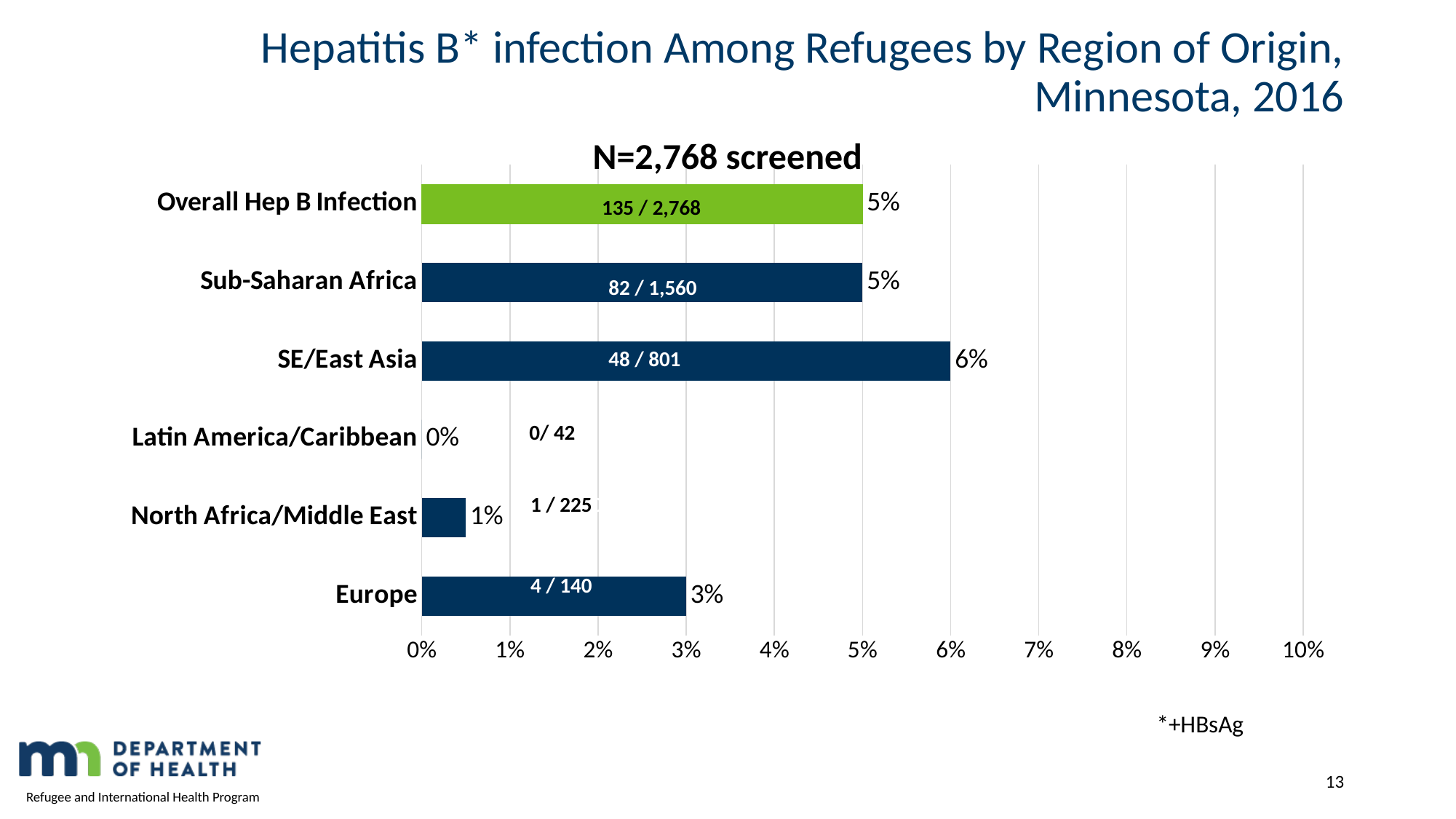
Which has a higher infection percentage, Europe or North Africa/Middle East? Europe What fraction is shown for Latin America/Caribbean? 0/ 42 What is the Hepatitis B infection percentage for SE/East Asia? 6% What is the Hepatitis B infection percentage for Europe? 3% Which region has the lowest Hepatitis B infection percentage? Latin America/Caribbean What fraction is shown on the Sub-Saharan Africa bar? 82 / 1,560 What is the total number screened stated above the chart? N=2,768 screened Which region has the highest Hepatitis B infection percentage? SE/East Asia What is the difference in percentage points between SE/East Asia and Europe? 3% What is the Hepatitis B infection percentage for North Africa/Middle East? 1% How many categories are shown on the chart? 6 What type of chart is shown on the slide? Bar chart